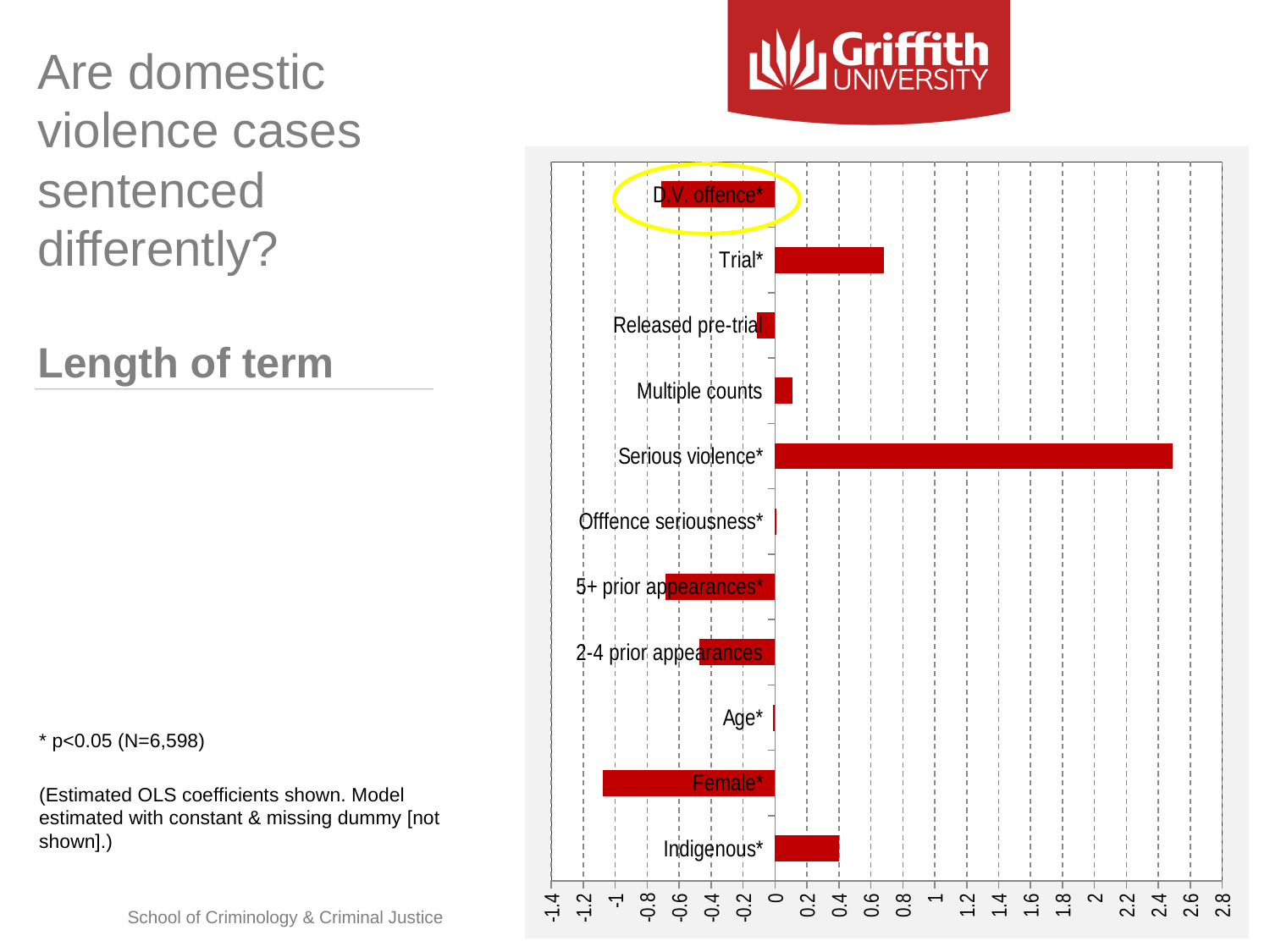
Which category has the highest value on the chart? Serious violence* Which category has the lowest value on the chart? Female* Is the value for Serious violence* greater or less than 2? greater Is the value for D.V. offence* greater or less than -0.4? less Which has the larger value, Multiple counts or Serious violence*? Serious violence* Is the value for 2-4 prior appearances greater or less than -0.2? less Which has the larger value, Trial* or Indigenous*? Trial* How many categories are plotted on the chart? 11 What colour are the bars on the chart? red What kind of chart is shown on the slide? bar chart